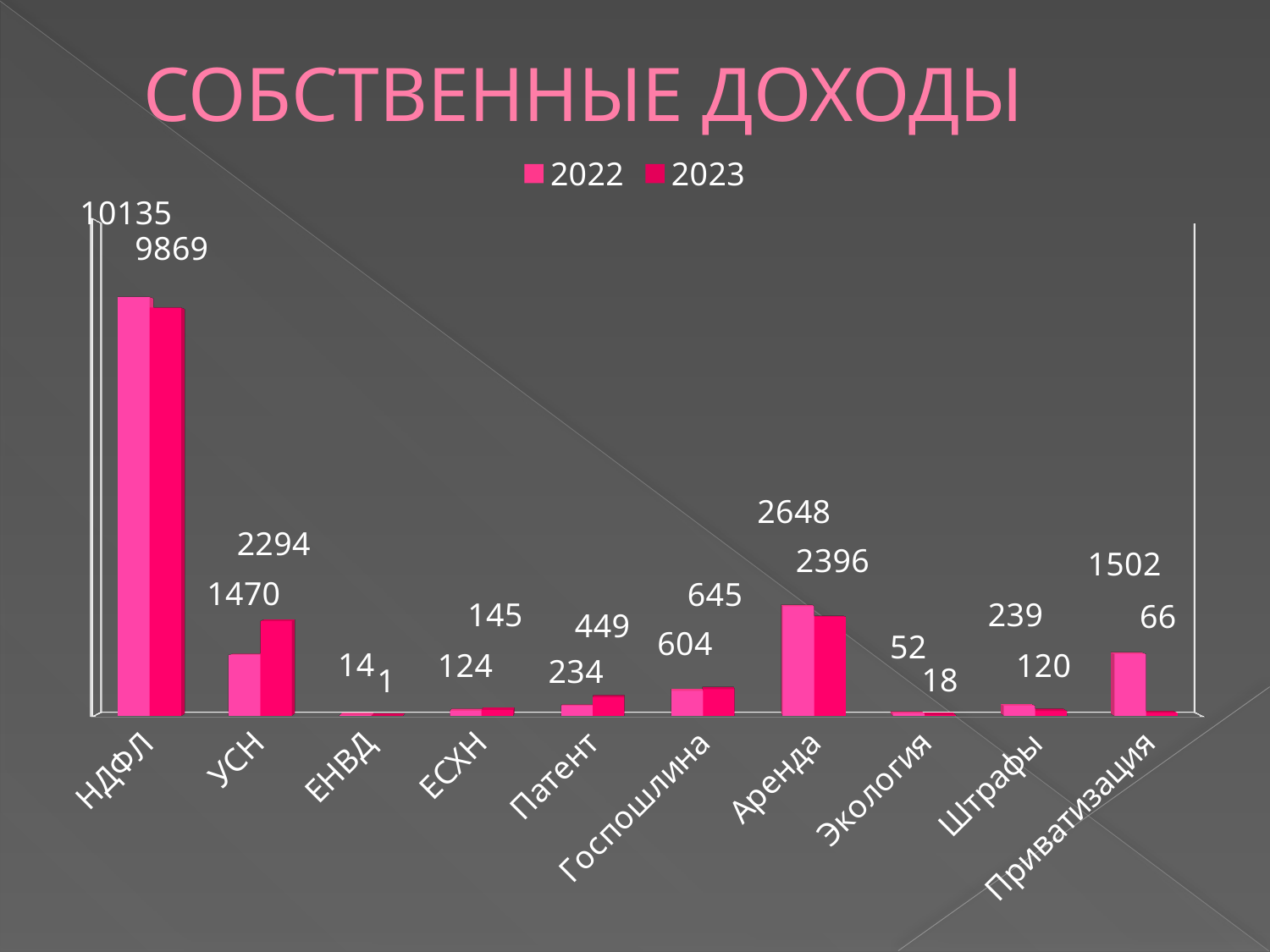
What is the difference between the 2022 and 2023 values for Патент? 215 What is the 2023 value for УСН? 2294 Which is larger for Штрафы: the 2022 value or the 2023 value? 2022 Which category has the highest 2023 value? НДФЛ How many categories are shown on the x axis? 10 What is the title of the chart? СОБСТВЕННЫЕ ДОХОДЫ Which category has the lowest 2023 value? ЕНВД What kind of chart is shown on the slide? Bar chart How many series does the legend list? 2 What is the 2023 value for Приватизация? 66 What is the 2022 value for НДФЛ? 10135 What is the 2022 value for Аренда? 2648